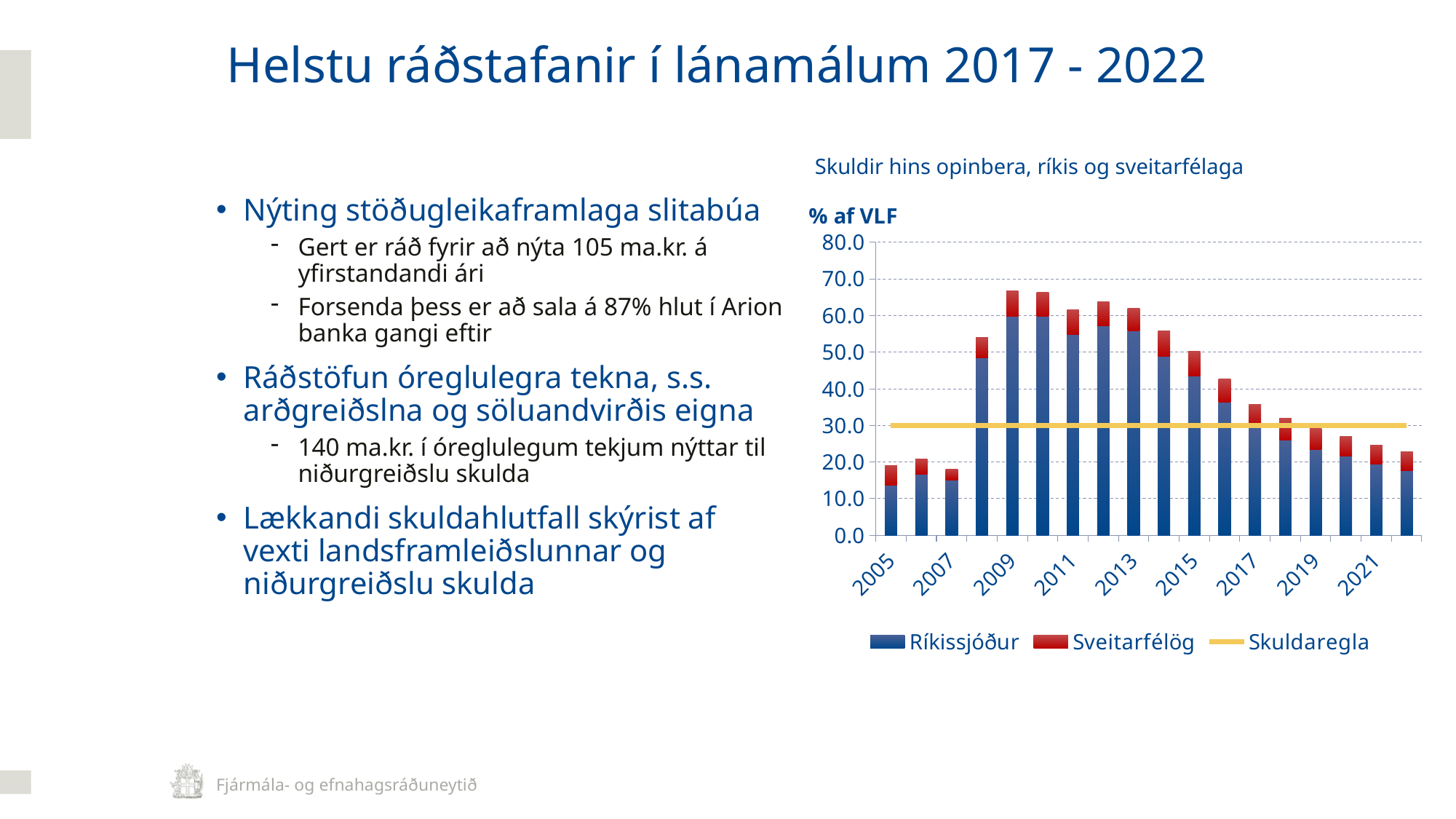
What kind of chart is shown on the slide? Stacked bar chart with a line At what level does the Skuldaregla line run across the chart? 30.0 What is the title of the chart on the slide? Skuldir hins opinbera, ríkis og sveitarfélaga Do the total bar values rise or fall from 2010 to 2022? fall What is the unit label shown above the vertical axis of the chart? % af VLF Is the total value of the bar for 2009 greater or less than 60.0? greater Is the total value of the bar for 2015 greater or less than 40.0? greater Is the total value of the bar for 2022 greater or less than 30.0? less How many entries does the chart legend list? 3 Which year has the larger total bar, 2009 or 2022? 2009 How many bars (years) are plotted in the chart? 18